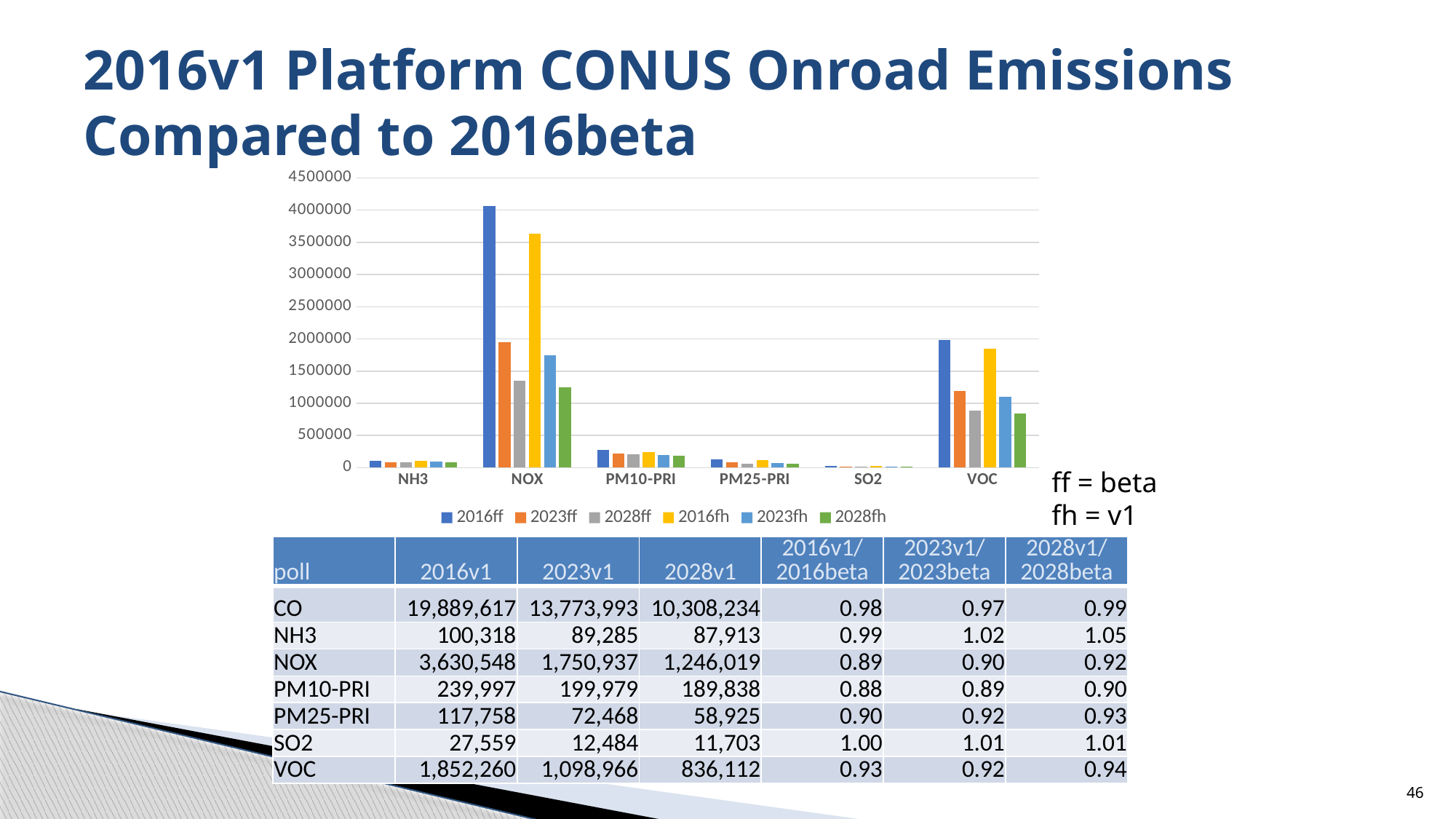
According to the note next to the chart, what does 'fh' stand for in the legend? v1 Is the 2028fh bar for VOC greater or less than 1000000? less For NOX, do the ff series bars rise or fall from 2016ff to 2028ff? fall Is the 2023fh bar for NOX greater or less than 1500000? greater How many pollutant categories are shown on the x axis of the chart? 6 Is the 2016ff bar for NOX greater or less than 3500000? greater How many series does the chart legend list? 6 What kind of chart is shown on the slide? bar chart Within the NOX category, which series has the tallest bar? 2016ff Which is larger for VOC, the 2016ff bar or the 2016fh bar? 2016ff Which pollutant category has the tallest bars in the chart? NOX Which pollutant category has the smallest bars in the chart? SO2